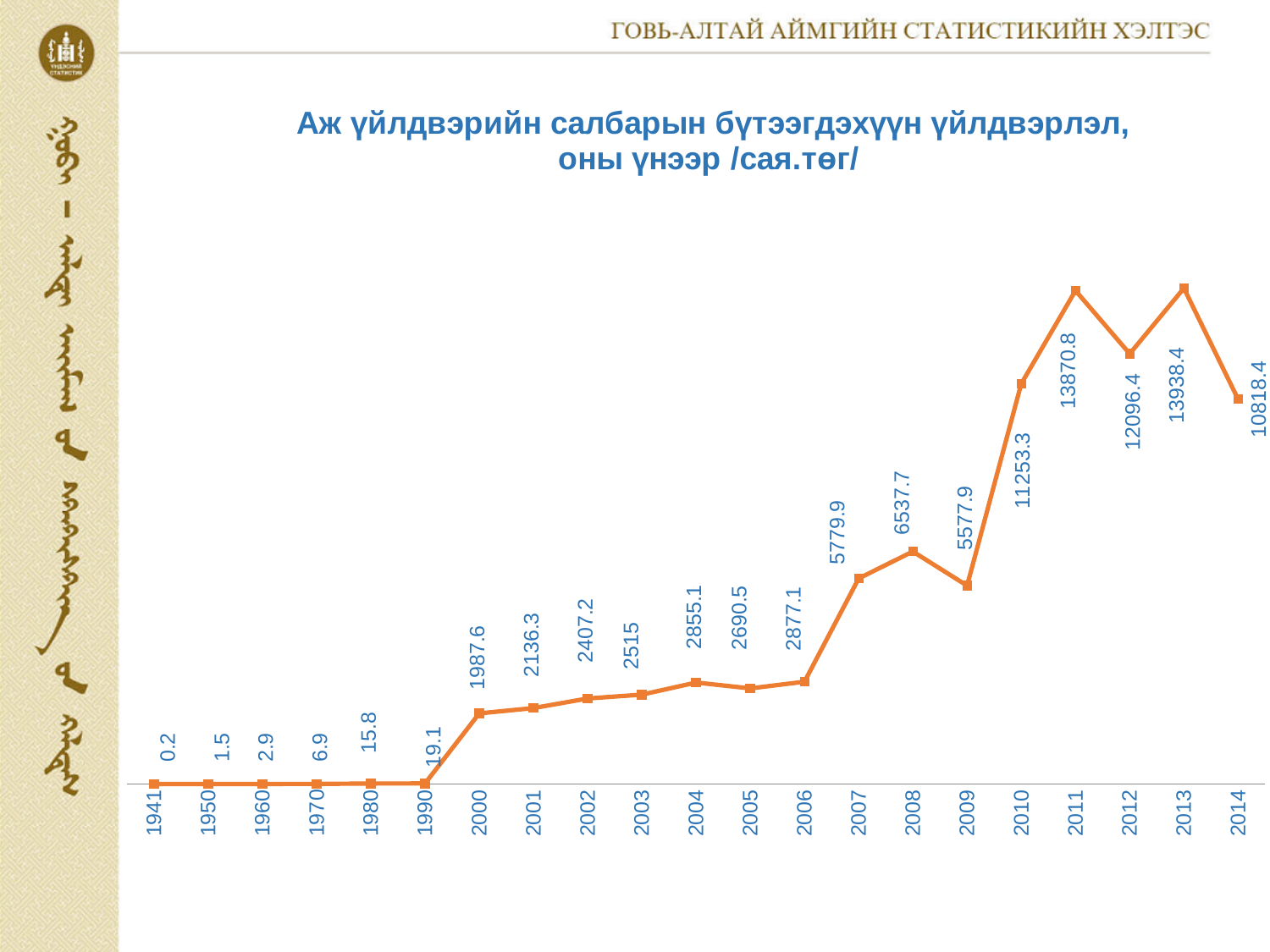
What is the value for 2000? 1987.6 Which is larger, the value for 2009 or the value for 2008? 2008 How many data points are plotted on the chart? 21 What is the difference between the values for 2008 and 2007? 757.8 What type of chart is shown on the slide? line chart Do the values generally rise or fall from 1941 to 2013? rise What is the value for 2014? 10818.4 What is the difference between the values for 2013 and 2012? 1842 Which year has the highest value? 2013 Which year has the lowest value? 1941 What is the value for 2010? 11253.3 What is the value for 1980? 15.8